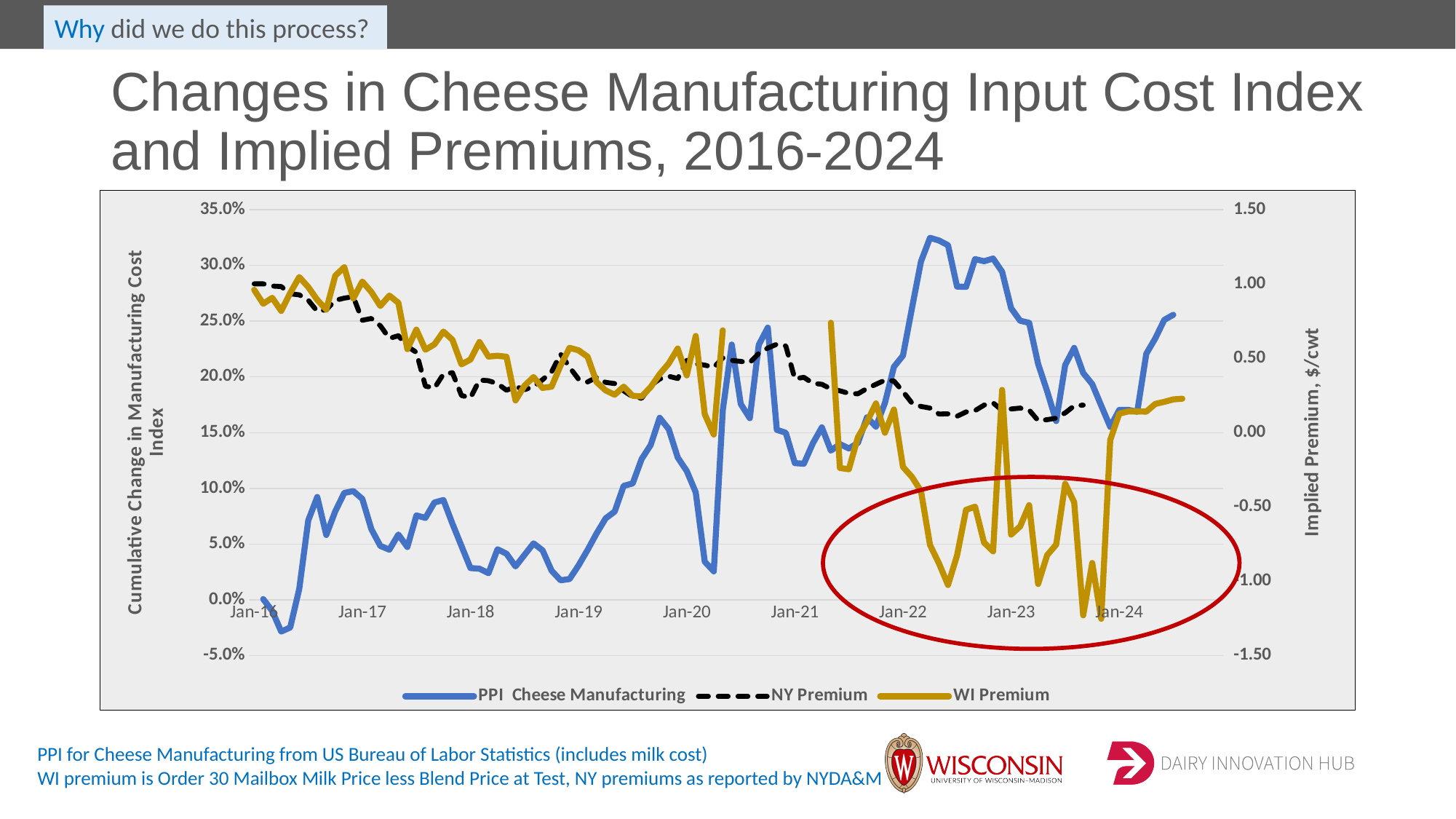
Does the NY Premium line generally rise or fall from Jan-16 to Jan-24? fall What is the label of the left vertical axis? Cumulative Change in Manufacturing Cost Index How many series does the chart's legend list? 3 Is the value for PPI Cheese Manufacturing at Jan-24 greater or less than 20.0%? less Is the value for WI Premium at Jan-22 greater or less than 0.00? less What kind of chart is shown on the slide? line chart Is the value for PPI Cheese Manufacturing at Jan-17 greater or less than 5.0%? greater At Jan-22, which is higher, NY Premium or WI Premium? NY Premium What are the three series named in the legend? PPI Cheese Manufacturing, NY Premium, WI Premium In which year does the PPI Cheese Manufacturing line reach its highest point? 2022 How many year labels are shown on the x axis? 9